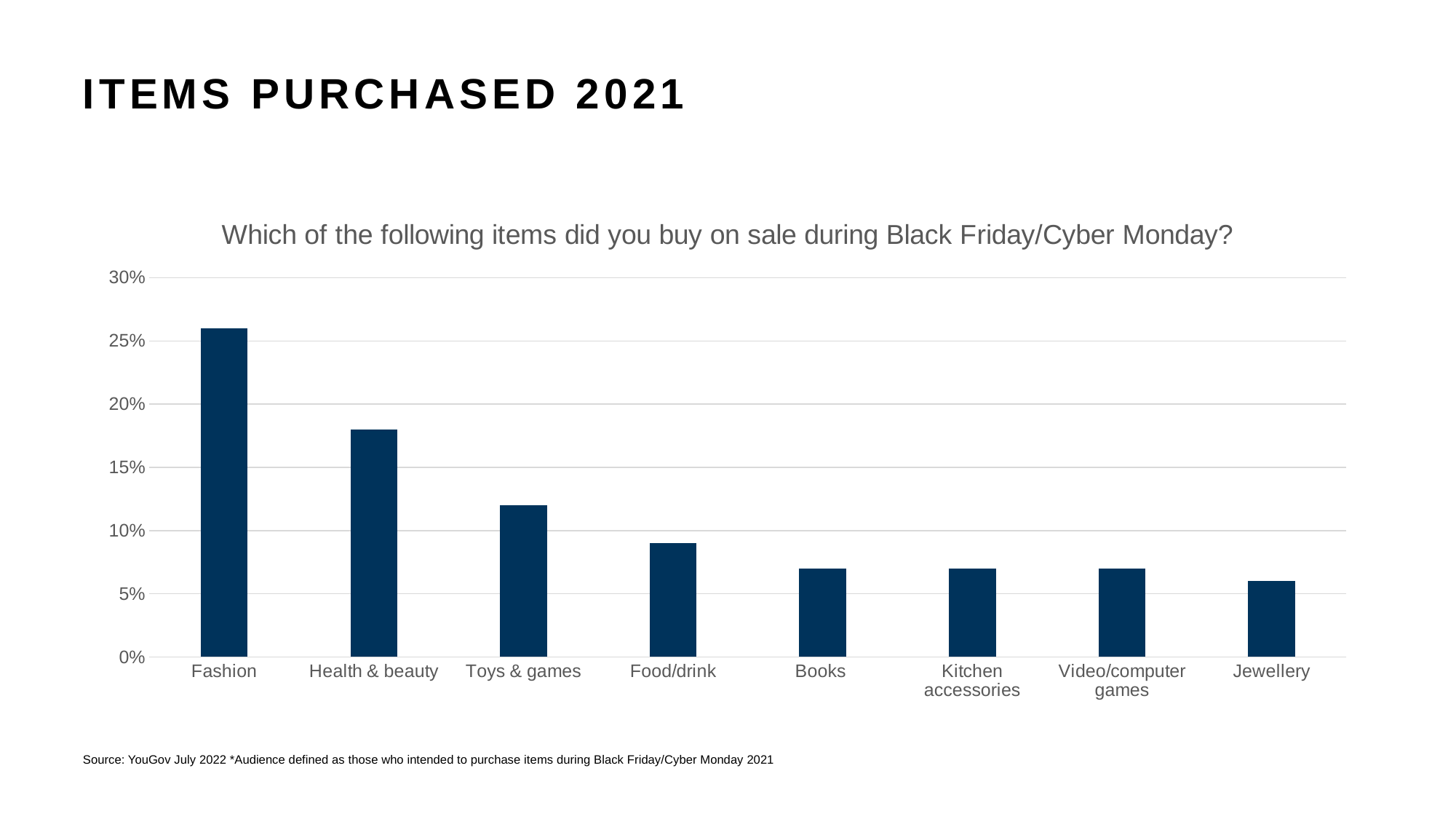
How many item categories are shown on the x axis of the chart? 8 Which has a larger value, Books or Fashion? Fashion Is the value for Toys & games greater or less than 10%? greater Which item category has the highest value in the chart? Fashion Is the value for Jewellery greater or less than 5%? greater What is the title of the chart? Which of the following items did you buy on sale during Black Friday/Cyber Monday? Which has a larger value, Health & beauty or Toys & games? Health & beauty Do the values generally rise or fall moving from left to right along the x axis? fall What kind of chart is shown on the slide? bar chart Is the value for Food/drink greater or less than 10%? less